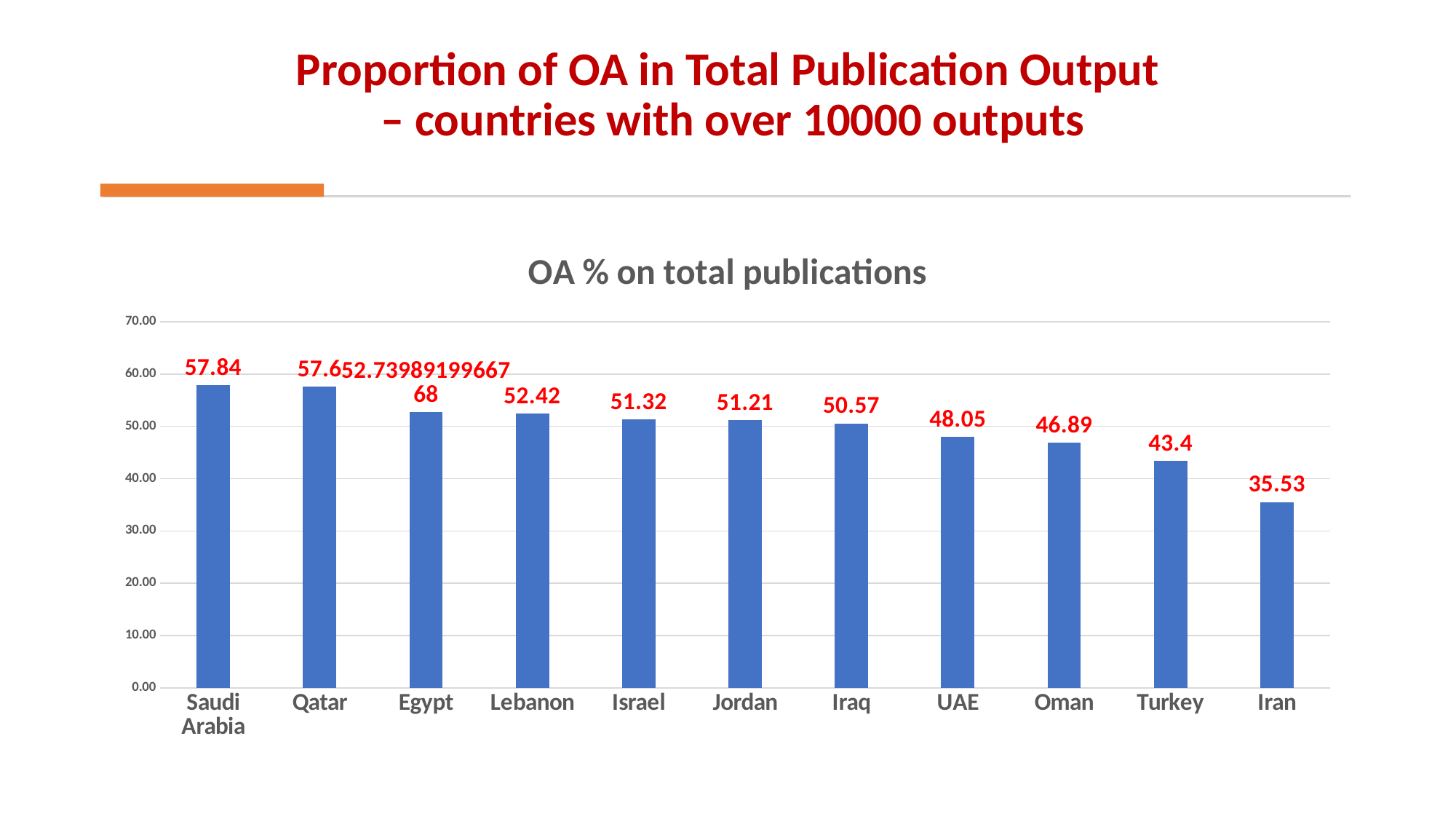
Which country has the lowest OA % on total publications? Iran Which has a higher OA % value, Iraq or Oman? Iraq What is the OA % value for Turkey? 43.4 What is the difference between the OA % values for UAE and Oman? 1.16 What is the difference between the OA % values for Lebanon and Iran? 16.89 How many countries are shown in the chart? 11 What kind of chart is shown on the slide? Bar chart What is the OA % value for Lebanon? 52.42 What is the OA % value for Iran? 35.53 Do the values generally rise or fall from left to right across the countries? Fall What is the OA % value for UAE? 48.05 Is the value for Oman greater or less than 50.00? less